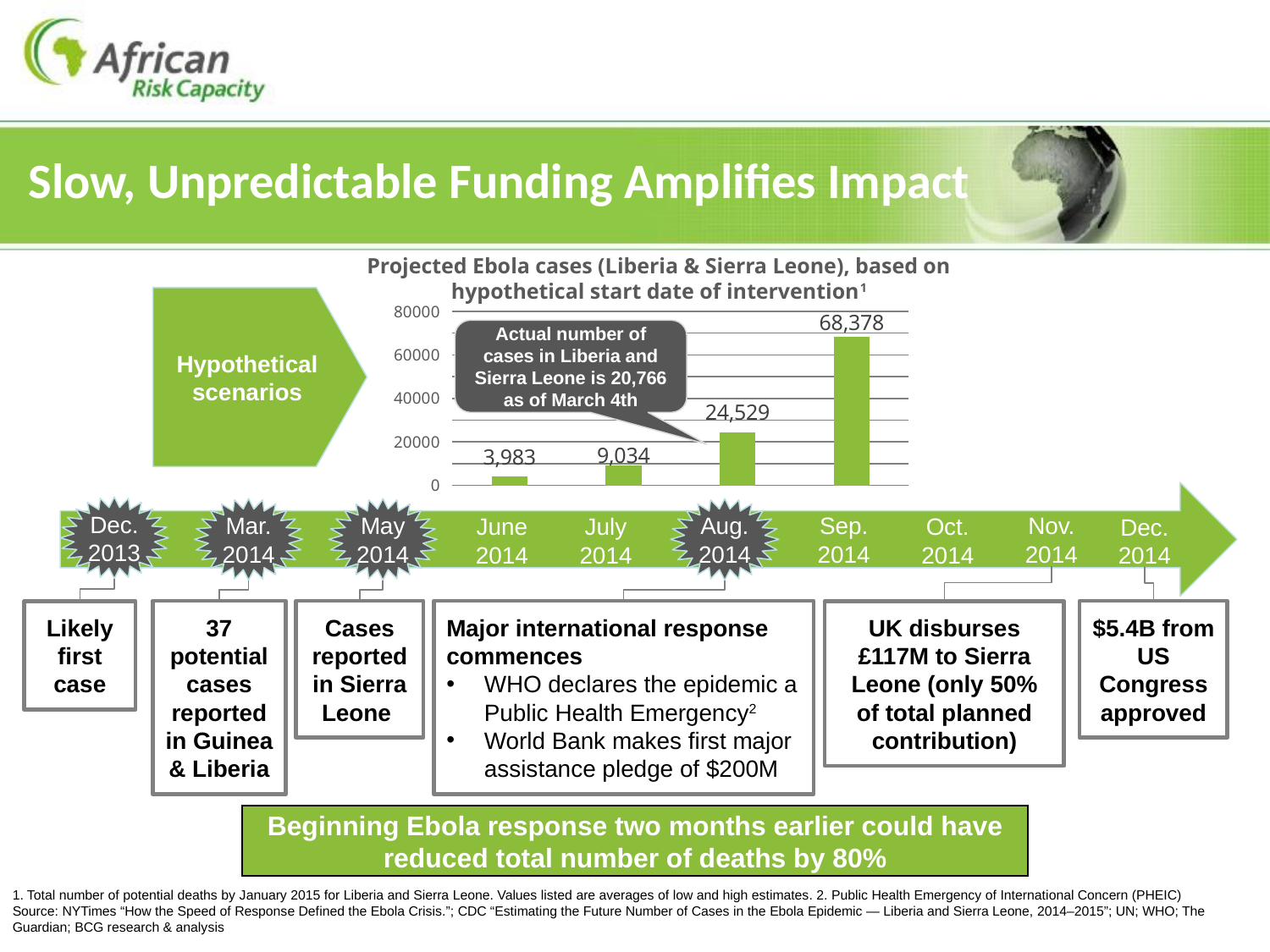
Do the bar values rise or fall from left to right across the chart? rise What is the difference between the rightmost bar (68,378) and the third bar (24,529)? 43,849 According to the callout on the chart, what is the actual number of cases in Liberia and Sierra Leone as of March 4th? 20,766 What is the value of the shortest (leftmost) bar in the chart? 3,983 What is the difference between the third bar (24,529) and the second bar (9,034)? 15,495 Which bar in the chart is the highest? the fourth (rightmost) bar What is the value of the third bar from the left in the chart? 24,529 How many bars are plotted in the chart? 4 What is the value of the second bar from the left in the chart? 9,034 What kind of chart is shown on the slide? bar chart What is the value of the tallest (rightmost) bar in the chart? 68,378 Is the value of the rightmost bar greater or less than 60000? greater